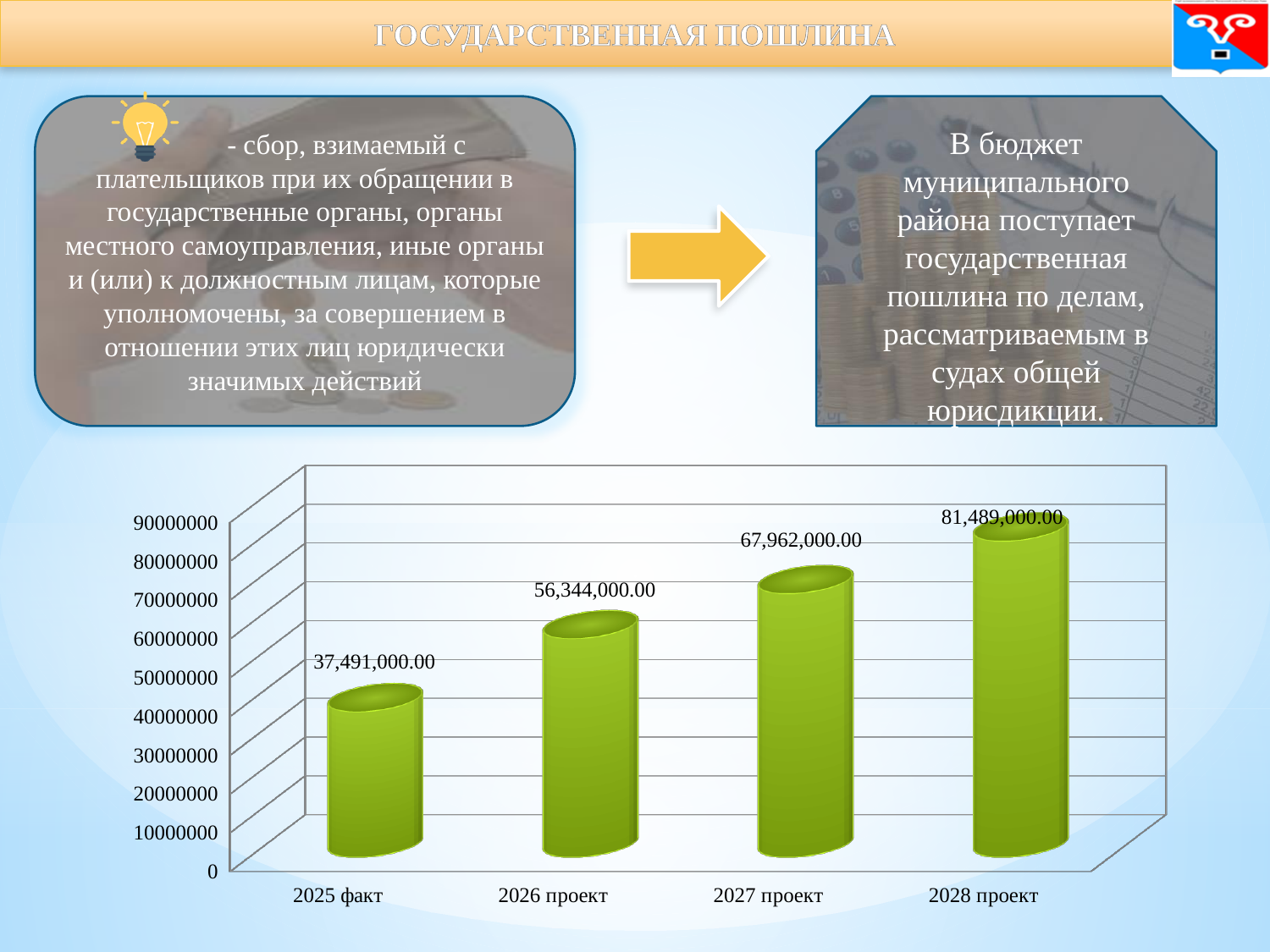
What is the value for 2028 проект? 81,489,000.00 What is the value for 2025 факт? 37,491,000.00 What is the difference between the values for 2026 проект and 2025 факт? 18,853,000.00 What kind of chart is shown on the slide? Bar chart What is the difference between the values for 2028 проект and 2027 проект? 13,527,000.00 Which category has the highest value? 2028 проект What is the value for 2027 проект? 67,962,000.00 Which category has the lowest value? 2025 факт How many categories are shown on the x axis? 4 Do the values rise or fall from 2025 факт to 2028 проект? Rise Which is larger, the value for 2027 проект or the value for 2026 проект? 2027 проект What is the value for 2026 проект? 56,344,000.00